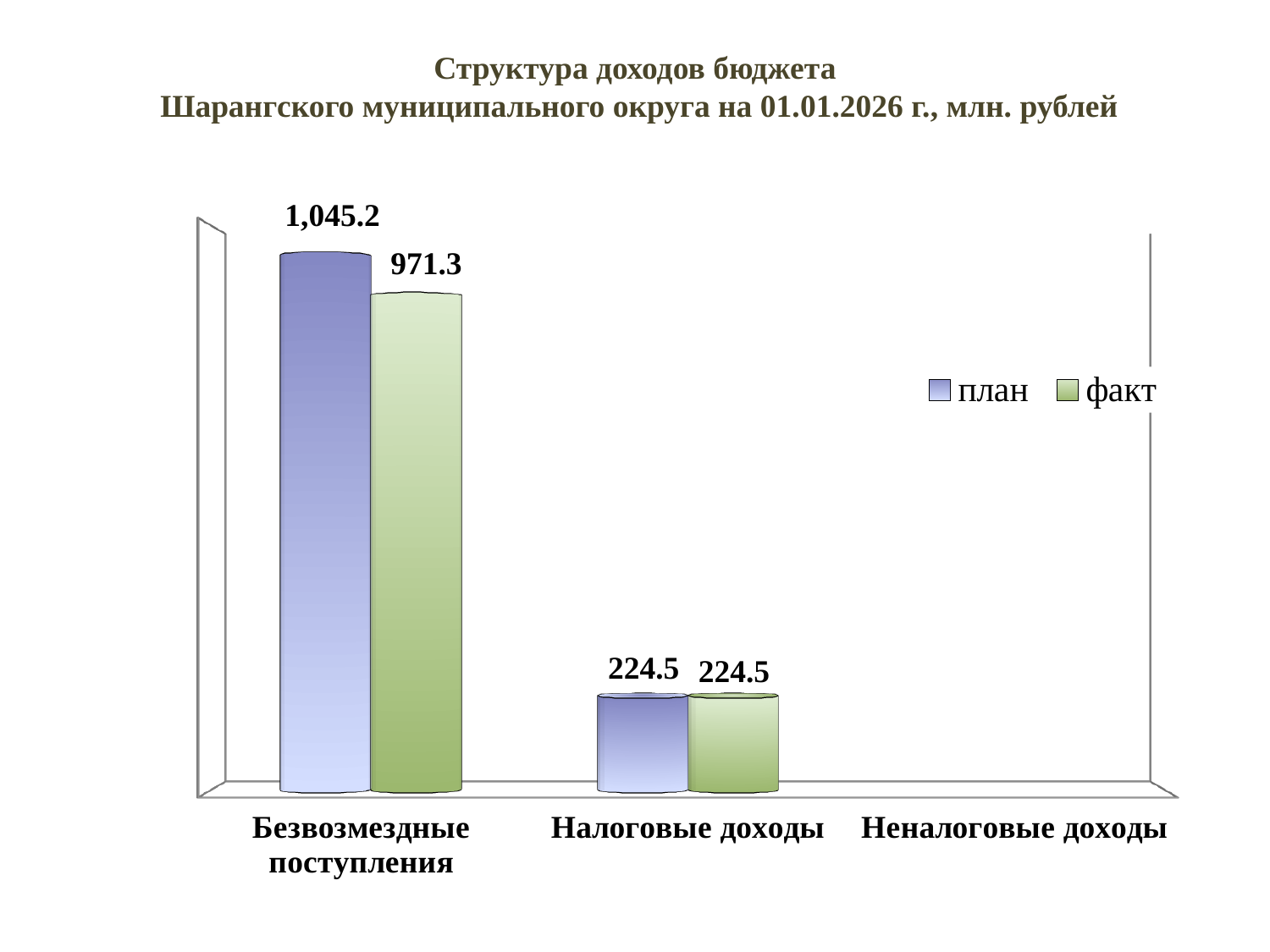
What is the факт value for Безвозмездные поступления? 971.3 What is the difference between the план values for Безвозмездные поступления and Налоговые доходы? 820.7 How many series does the legend list? 2 What is the факт value for Налоговые доходы? 224.5 What is the план value for Налоговые доходы? 224.5 What is the план value for Безвозмездные поступления? 1,045.2 Which category has the highest план value? Безвозмездные поступления Which is larger for Безвозмездные поступления, the план value or the факт value? план What are the two series named in the legend? план and факт What is the difference between the план and факт values for Безвозмездные поступления? 73.9 What kind of chart is shown on the slide? bar chart How many categories are shown on the x axis? 3